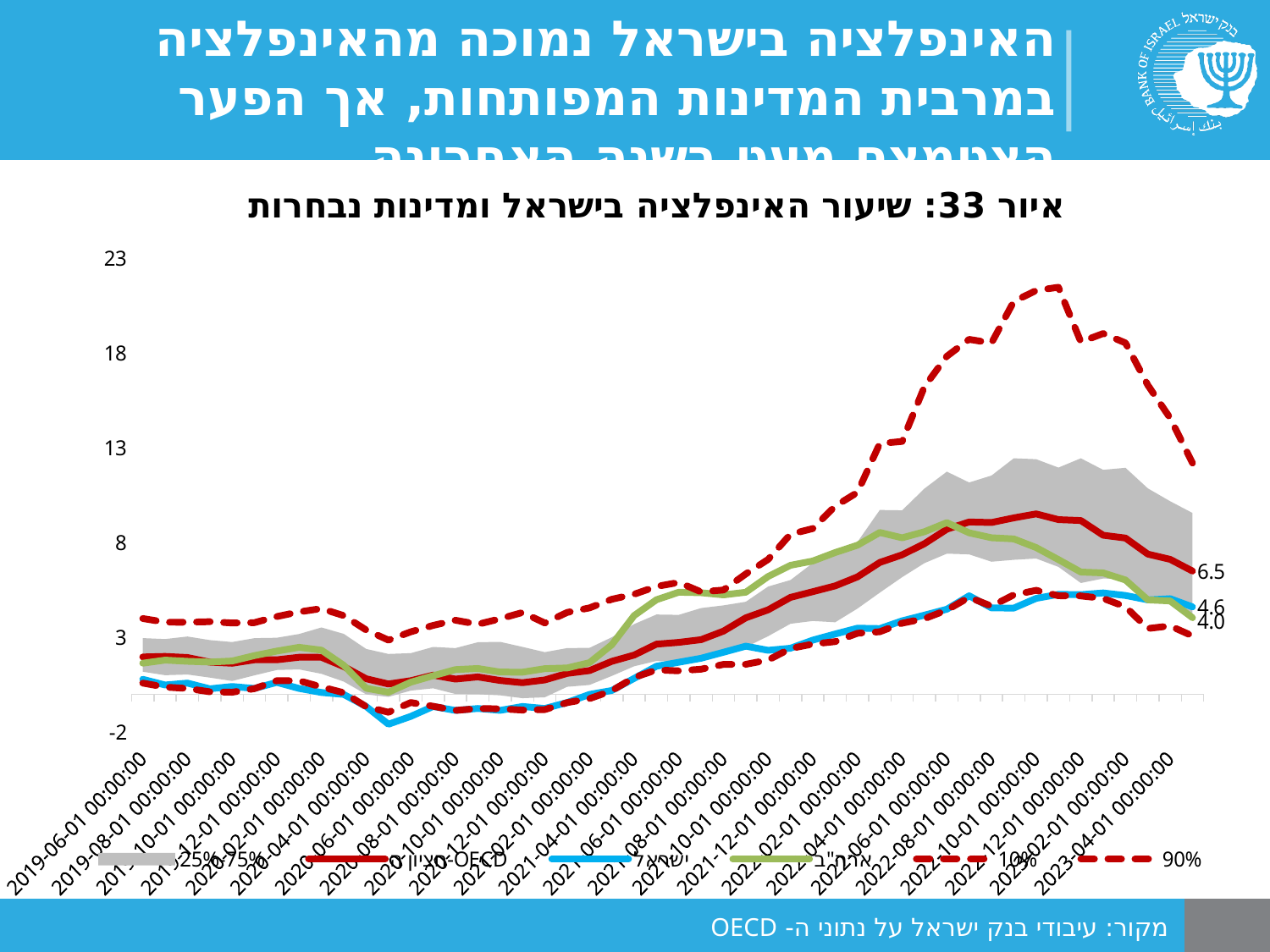
Does the OECD median line rise or fall between 2021-01-01 and 2022-10-01? rise Is the OECD median value at the end of the chart greater or less than 8? less Is the value of the Israel (ישראל) line around 2020-06-01 greater or less than 3? less What kind of chart is shown on the slide? line chart What is the figure number given in the chart title? 33 At the right end of the chart, which is higher: the OECD median line or the Israel line? OECD median Is the peak of the 90% dashed line greater or less than 18? greater What is the value printed at the end of the OECD median (חציון-OECD) line? 6.5 How many entries does the chart legend list? 6 Does the 90% dashed line rise or fall between 2022-12-01 and 2023-04-01? fall What is the highest value labeled on the vertical axis? 23 Which series reaches the highest value on the chart? 90%